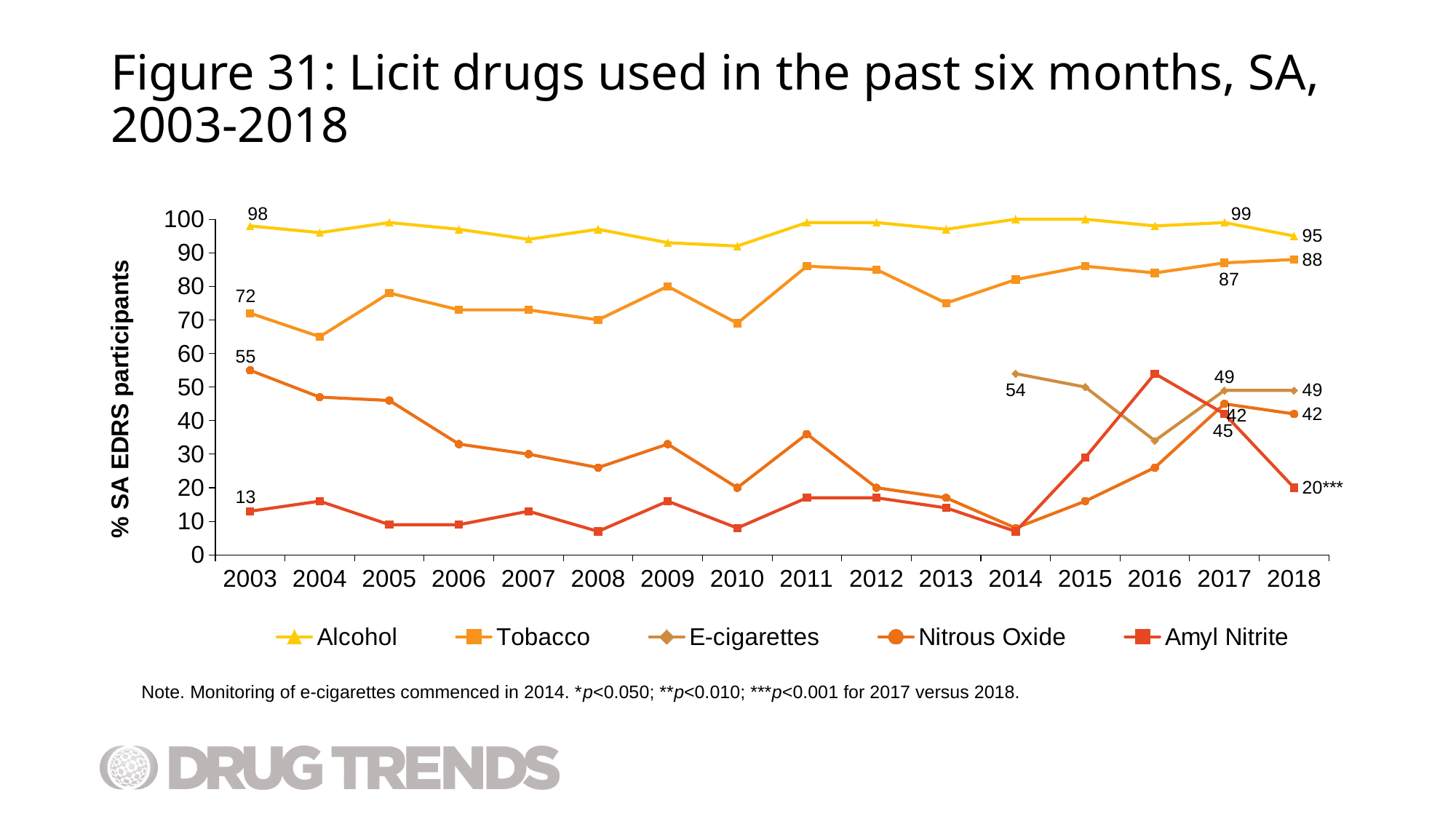
How many series does the legend list? 5 By how much did the Tobacco value increase from 2003 to 2018? 16 What is the label on the y axis? % SA EDRS participants What is the value for E-cigarettes in 2014? 54 What is the value for Nitrous Oxide in 2003? 55 What kind of chart is shown on the slide? line chart How many years are shown on the x axis? 16 Which series has the lowest value in 2003? Amyl Nitrite What is the value for Tobacco in 2018? 88 What is the difference between the Alcohol values for 2017 and 2018? 4 What is the value for Alcohol in 2003? 98 Is the value for Nitrous Oxide in 2010 greater or less than 30? less